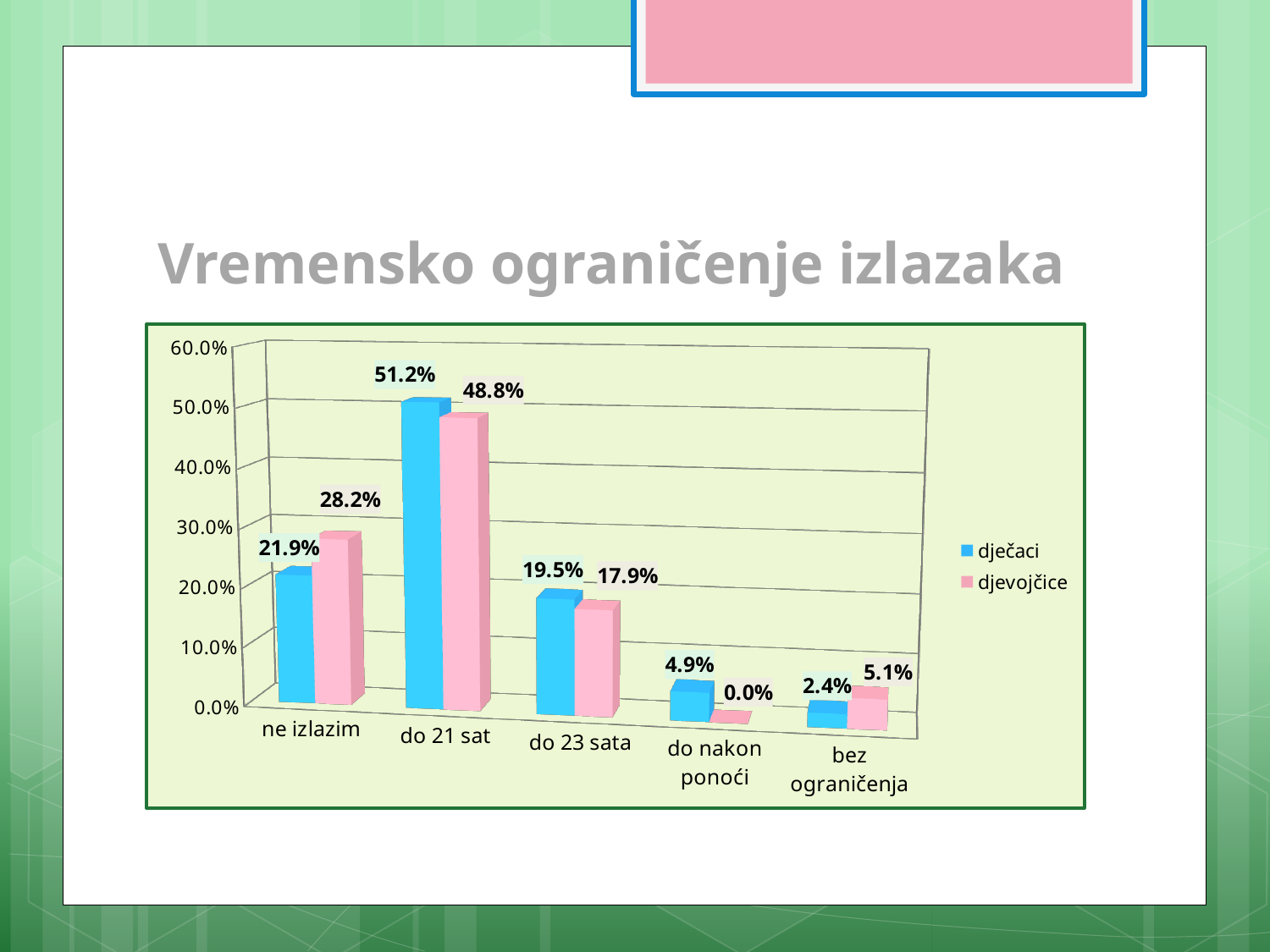
What is the title of the slide above the chart? Vremensko ograničenje izlazaka Which is larger in the 'ne izlazim' category, dječaci or djevojčice? djevojčice Which category has the highest value for djevojčice? do 21 sat What is the value for dječaci in the 'bez ograničenja' category? 2.4% How many categories are shown on the x axis? 5 What is the value for djevojčice in the 'do nakon ponoći' category? 0.0% How many series does the legend list? 2 What is the value for djevojčice in the 'ne izlazim' category? 28.2% Which category has the lowest value for dječaci? bez ograničenja What is the value for dječaci in the 'do 21 sat' category? 51.2% What is the difference between dječaci and djevojčice in the 'do 23 sata' category? 1.6% What kind of chart is shown on the slide? bar chart